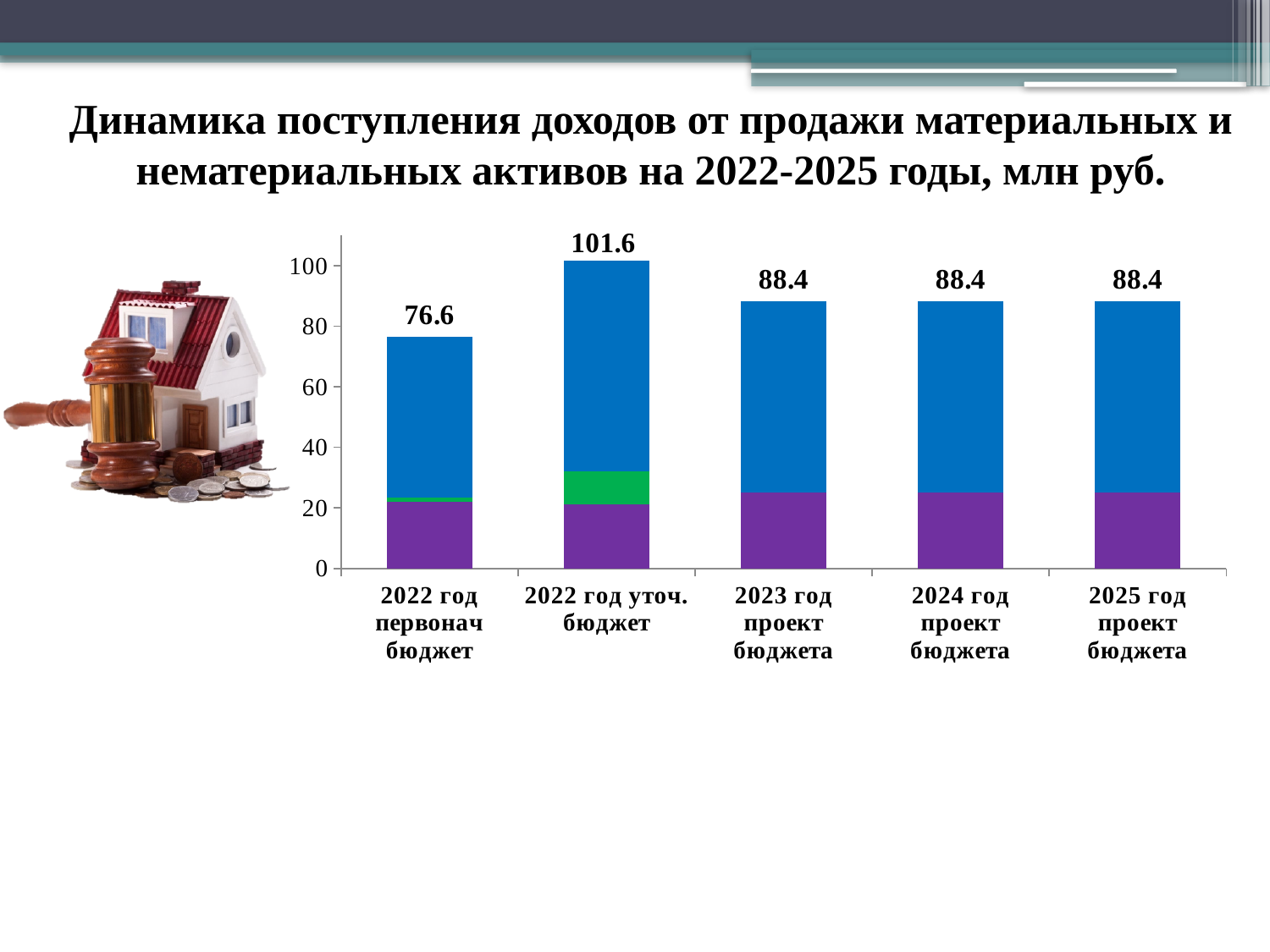
How many categories are shown on the x axis of the chart? 5 What kind of chart is shown on the slide? bar chart Is the total value for "2024 год проект бюджета" greater or less than 80? greater Which category has the lowest total value? 2022 год первонач бюджет Which is larger: the total for "2022 год первонач бюджет" or the total for "2023 год проект бюджета"? 2023 год проект бюджета What is the total value shown for the bar labelled "2022 год уточ. бюджет"? 101.6 What is the total value shown for the bar labelled "2023 год проект бюджета"? 88.4 Do the total values change from "2023 год проект бюджета" to "2025 год проект бюджета"? No, they stay the same at 88.4 What is the difference between the totals for "2022 год уточ. бюджет" and "2022 год первонач бюджет"? 25 By how much does the total for "2022 год уточ. бюджет" exceed the total for "2024 год проект бюджета"? 13.2 What is the total value shown for the bar labelled "2022 год первонач бюджет"? 76.6 Which category has the highest total value? 2022 год уточ. бюджет